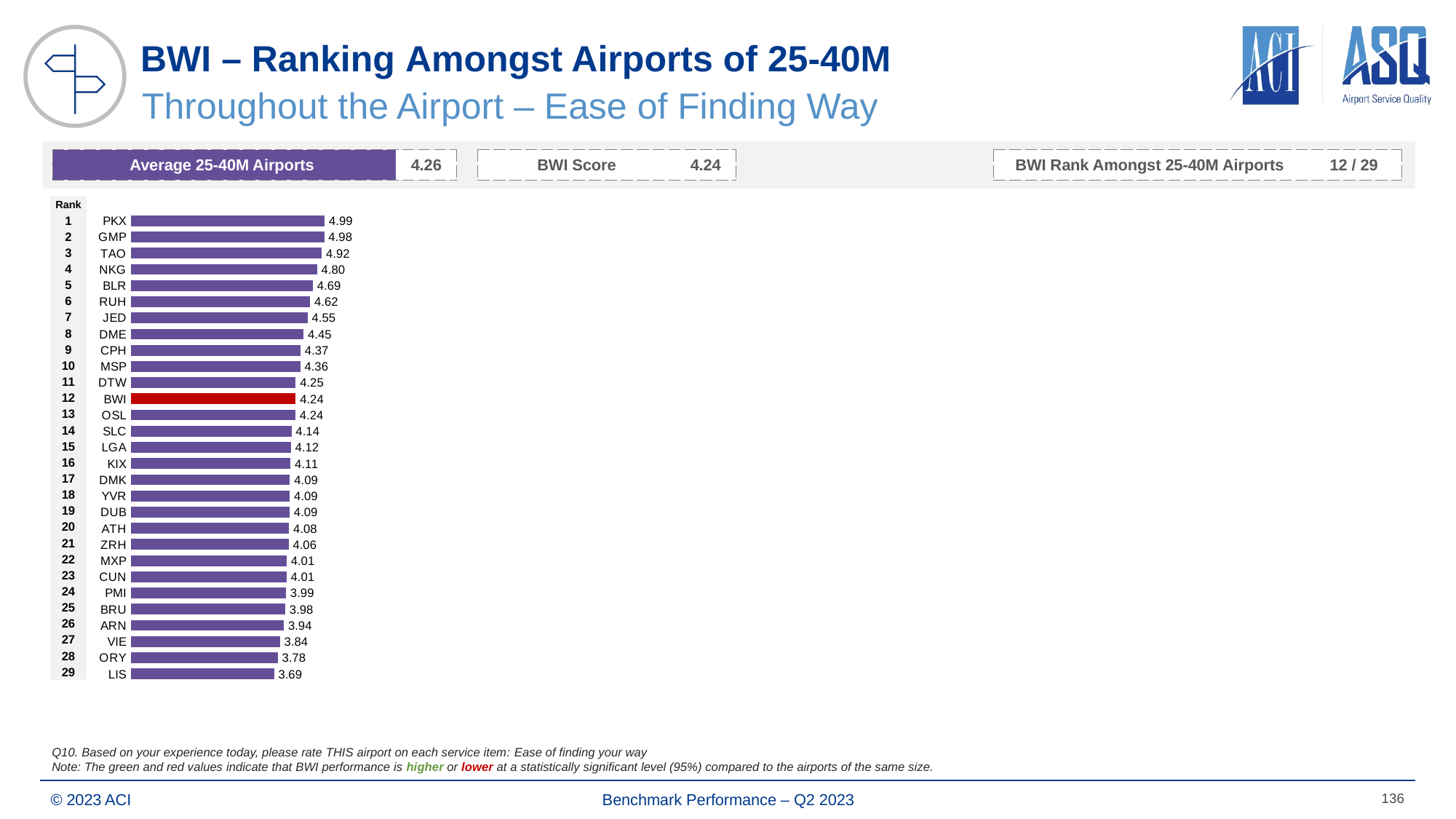
Which has a higher score, NKG or MSP? NKG Which airport has the highest score in the chart? PKX What kind of chart is shown on the slide? Bar chart How many airports are ranked in the chart? 29 What is the score for LIS? 3.69 Which bar in the chart is coloured red? BWI What is the difference between the scores of PKX and LIS? 1.30 What is the difference between the scores of DTW and BWI? 0.01 What is the score for PKX? 4.99 Do the scores rise or fall as you go down the ranking from rank 1 to rank 29? Fall What is the score for BWI in the ranking chart? 4.24 Which airport has the lowest score in the chart? LIS